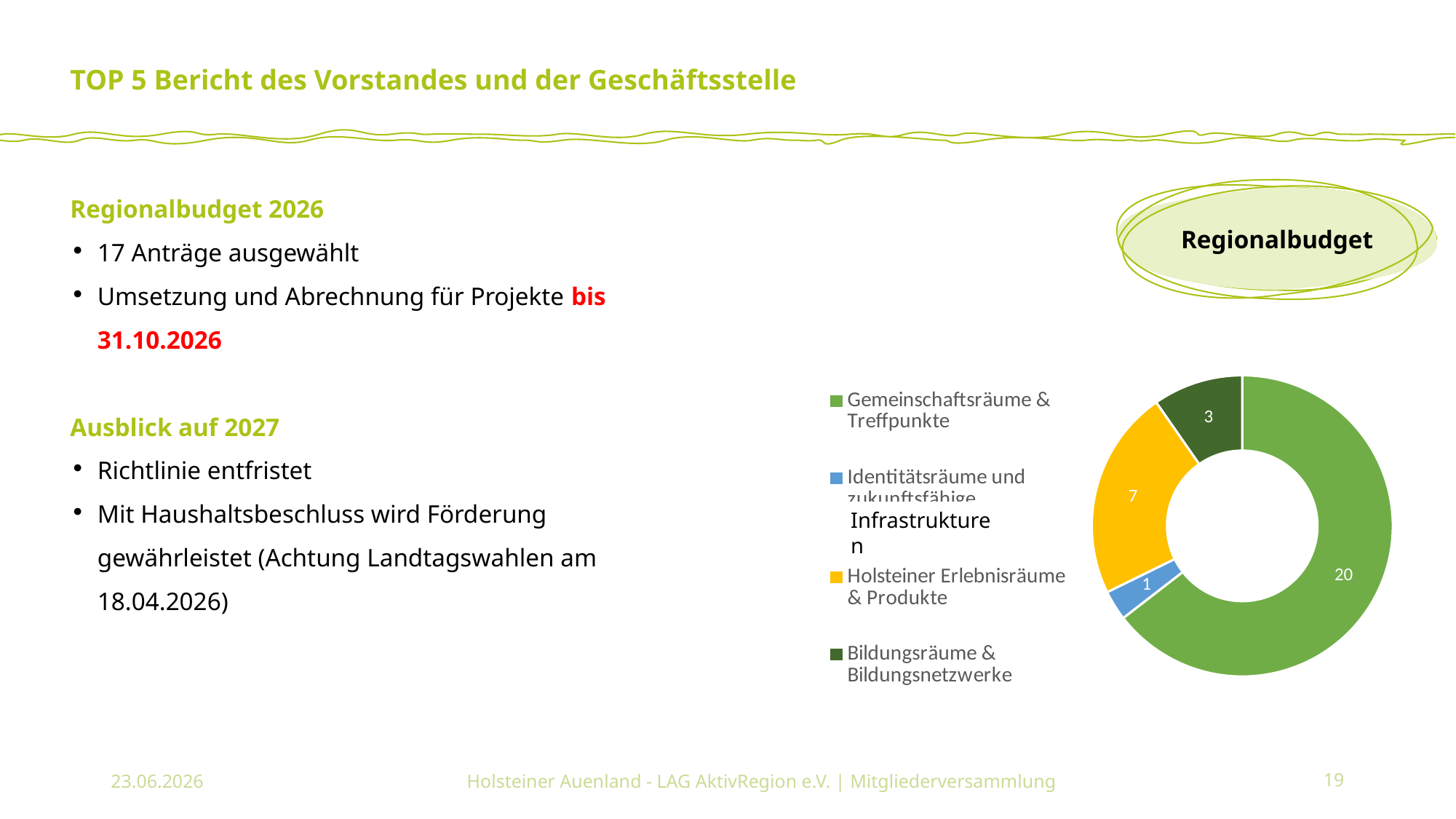
What type of chart is shown on the slide? Doughnut (pie) chart Which colour represents Holsteiner Erlebnisräume & Produkte in the doughnut chart? Yellow How many categories does the doughnut chart show? 4 What is the value for Identitätsräume und zukunftsfähige Infrastrukturen in the doughnut chart? 1 Which category has the smallest value in the doughnut chart? Identitätsräume und zukunftsfähige Infrastrukturen What is the value for Bildungsräume & Bildungsnetzwerke in the doughnut chart? 3 Which category has the largest value in the doughnut chart? Gemeinschaftsräume & Treffpunkte Which is larger: the value for Holsteiner Erlebnisräume & Produkte or for Bildungsräume & Bildungsnetzwerke? Holsteiner Erlebnisräume & Produkte What is the value for Gemeinschaftsräume & Treffpunkte in the doughnut chart? 20 What is the value for Holsteiner Erlebnisräume & Produkte in the doughnut chart? 7 What is the difference between the values for Gemeinschaftsräume & Treffpunkte and Holsteiner Erlebnisräume & Produkte? 13 What is the total of all values shown in the doughnut chart? 31